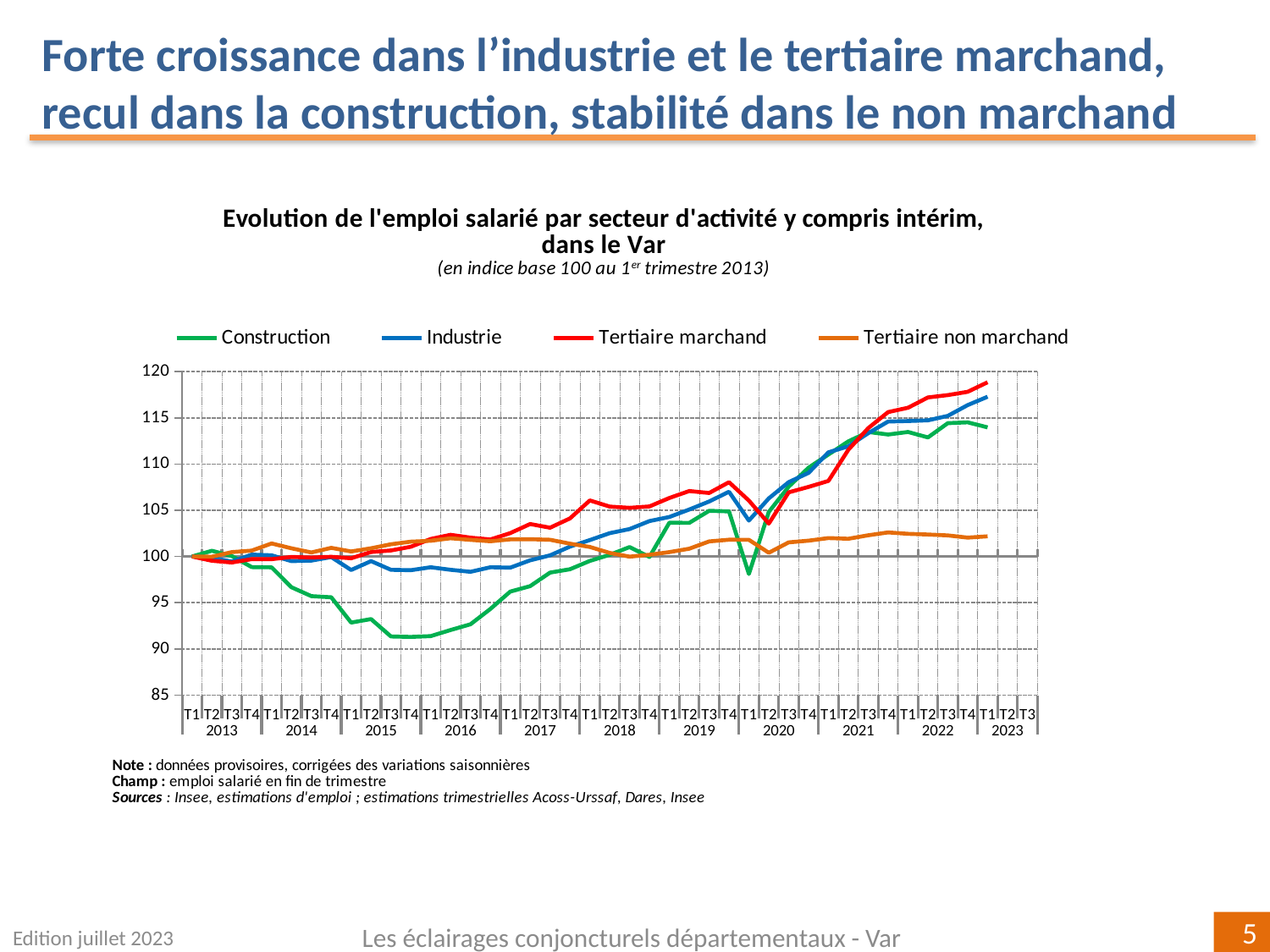
Is the value for Construction at T1 2020 greater or less than 100? less Which series has the highest value at T1 2023? Tertiaire marchand Does the Tertiaire marchand series rise or fall between T1 2013 and T1 2023? rise Does the Construction series rise or fall between T1 2013 and T4 2015? fall Is the value for Industrie at T1 2023 greater or less than 115? greater Which series has the lowest value at T1 2023? Tertiaire non marchand What is the index value of all series at T1 2013? 100 How many series does the legend list? 4 At T1 2020, which is larger: the value for Construction or the value for Industrie? Industrie Is the value for Construction at T4 2015 greater or less than 95? less Which colour is used for the Construction series? green What kind of chart is shown on the slide? line chart